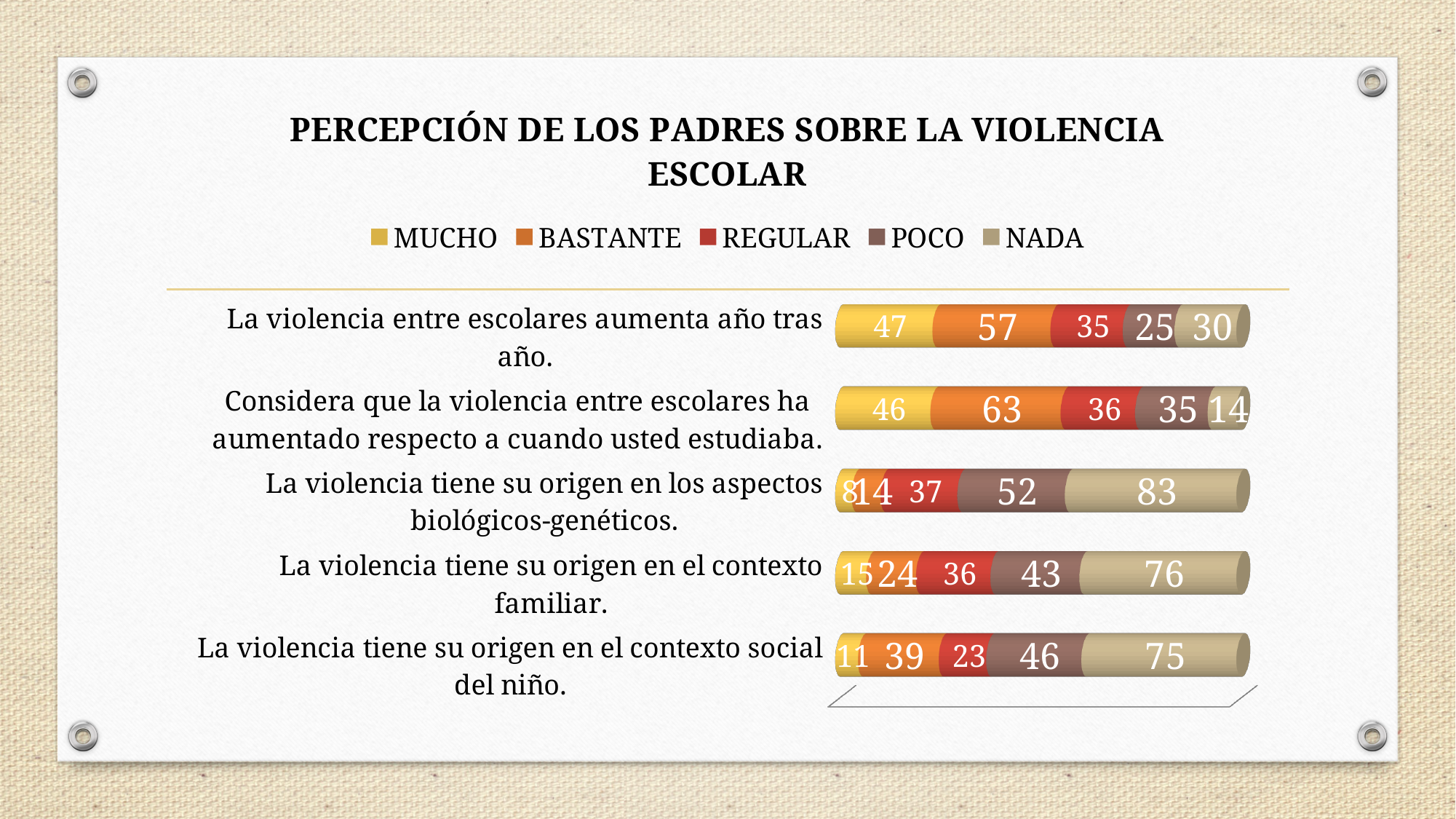
What type of chart is shown on the slide? Stacked bar chart What is the NADA value for 'La violencia tiene su origen en los aspectos biológicos-genéticos.'? 83 What is the difference between the NADA value for 'La violencia tiene su origen en el contexto familiar.' and the NADA value for 'La violencia entre escolares aumenta año tras año.'? 46 What is the MUCHO value for 'La violencia entre escolares aumenta año tras año.'? 47 How many categories (statements) are plotted in the chart? 5 Which statement has the lowest MUCHO value? La violencia tiene su origen en los aspectos biológicos-genéticos. What is the POCO value for 'La violencia tiene su origen en el contexto social del niño.'? 46 Which statement has the highest NADA value? La violencia tiene su origen en los aspectos biológicos-genéticos. How many series does the legend list? 5 Which is larger: the REGULAR value for 'La violencia tiene su origen en el contexto familiar.' or the REGULAR value for 'La violencia tiene su origen en el contexto social del niño.'? La violencia tiene su origen en el contexto familiar. What is the BASTANTE value for 'Considera que la violencia entre escolares ha aumentado respecto a cuando usted estudiaba.'? 63 What is the total of the stacked bar for 'La violencia tiene su origen en el contexto familiar.'? 194